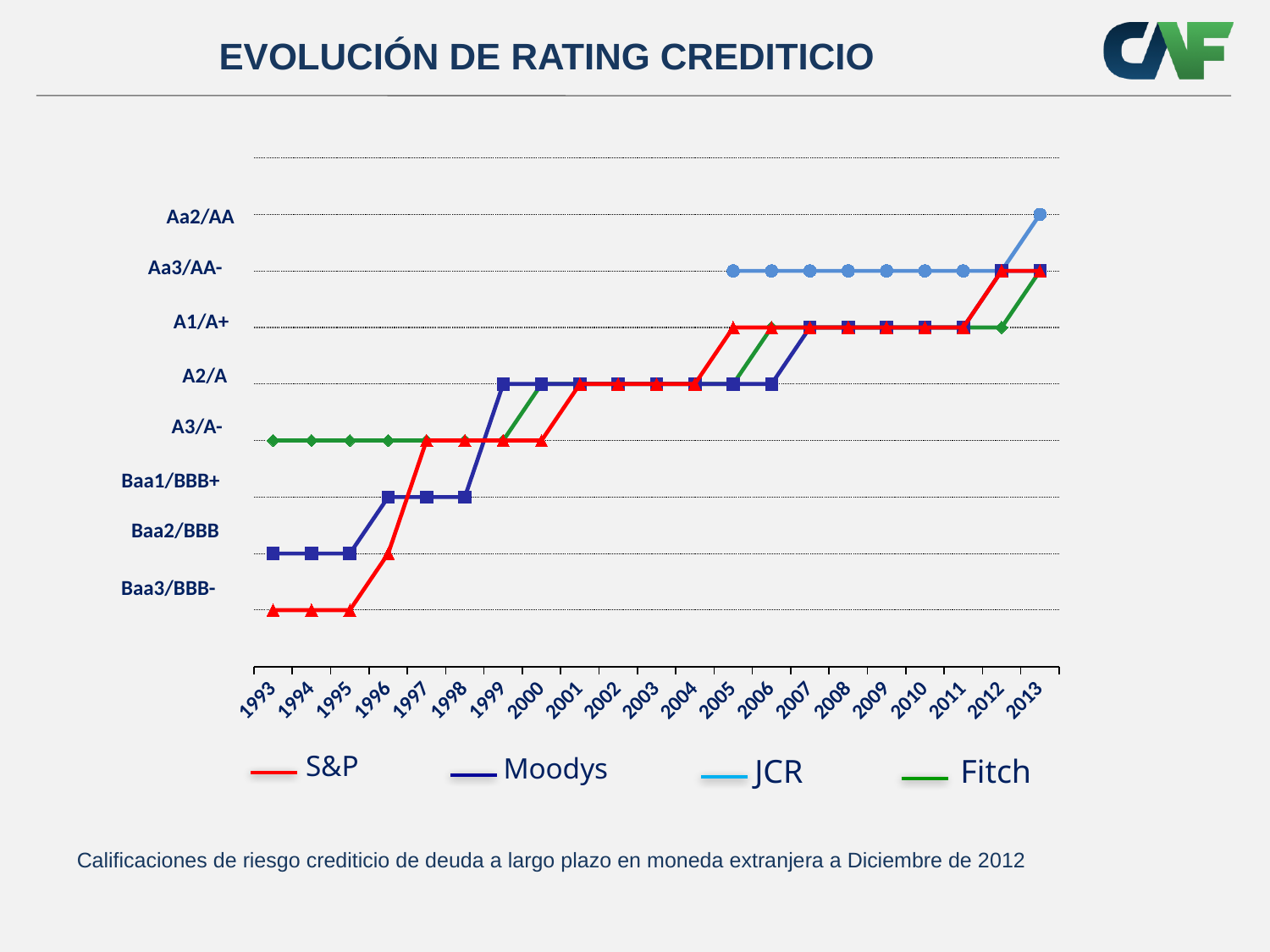
What rating does the S&P series show in 1993? Baa3/BBB- What rating does the Fitch series show in 1993? A3/A- Does the S&P rating rise or fall from 1993 to 2013? rise What is the title of the chart? EVOLUCIÓN DE RATING CREDITICIO What rating does the Moodys series show in 1993? Baa2/BBB What rating does the JCR series reach in 2013? Aa2/AA What kind of chart is shown on the slide? line chart In 2013, which series has the highest rating? JCR How many years are shown on the x axis? 21 How many series does the legend list? 4 Which series are listed in the legend? S&P, Moodys, JCR, Fitch In 1993, which series has the higher rating, Moodys or S&P? Moodys